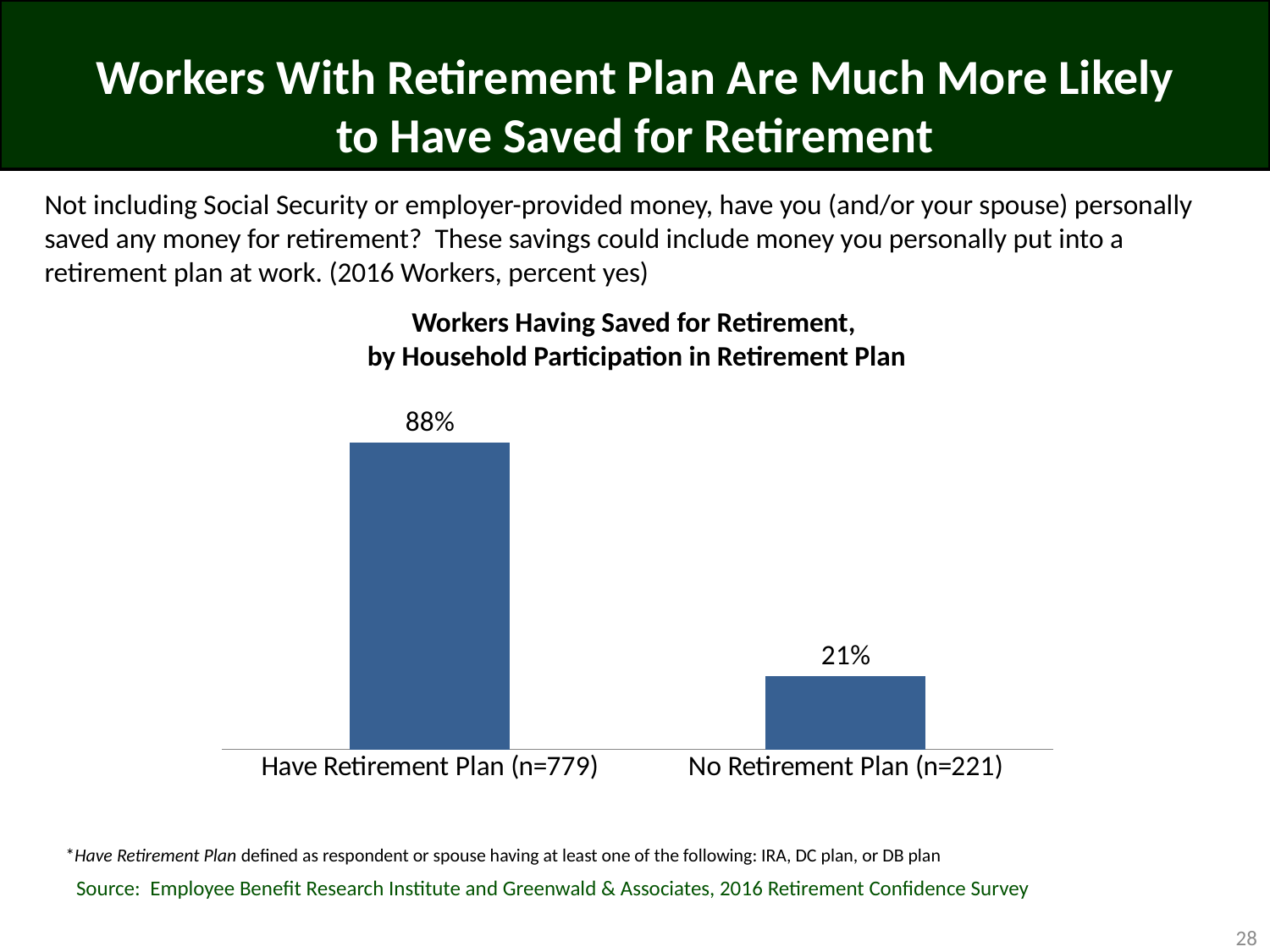
What is the difference in percentage points between workers with a retirement plan and those without? 67 percentage points Which category has the higher percentage of workers having saved for retirement? Have Retirement Plan (n=779) What is the sample size (n) for the Have Retirement Plan category? 779 Is the value for Have Retirement Plan larger or smaller than the value for No Retirement Plan? larger What is the title of the chart? Workers Having Saved for Retirement, by Household Participation in Retirement Plan What percentage of workers with no retirement plan (n=221) have saved for retirement? 21% What percentage of workers with a retirement plan (n=779) have saved for retirement? 88% Which category has the lower percentage of workers having saved for retirement? No Retirement Plan (n=221) What type of chart is shown on the slide? Bar chart How many categories are shown on the chart? 2